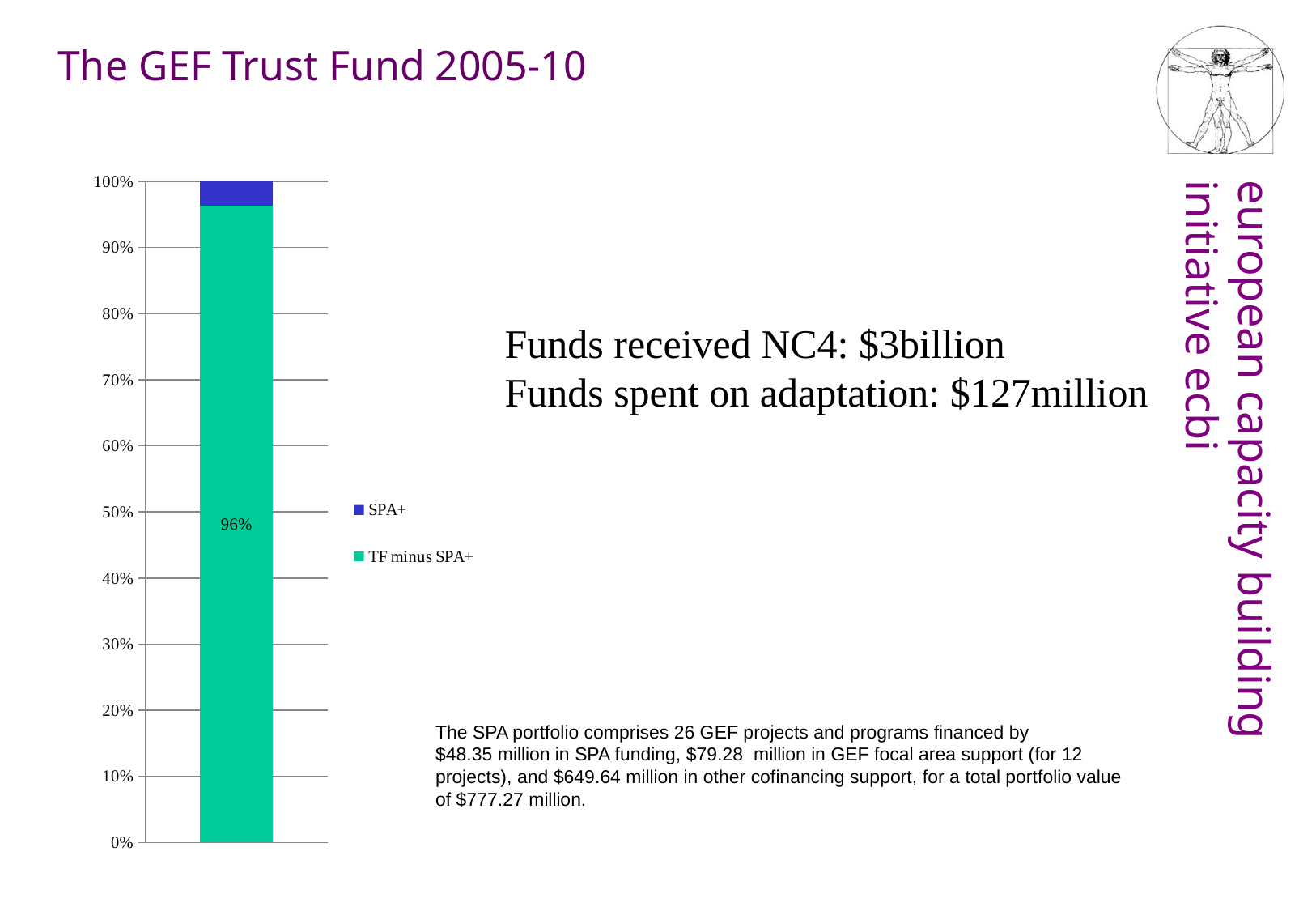
What are the two entries listed in the chart legend? SPA+ and TF minus SPA+ Which series takes up the larger share of the bar, SPA+ or TF minus SPA+? TF minus SPA+ What kind of chart is shown on the slide? Stacked bar chart How many series does the legend list? 2 Which series has the largest share of the stacked bar? TF minus SPA+ What percentage is shown for the TF minus SPA+ segment of the bar? 96% Is the value for TF minus SPA+ greater or less than 90%? greater Which series has the smallest share of the stacked bar? SPA+ How many bars are plotted in the chart? 1 What colour represents the SPA+ series in the chart? Blue Is the value for SPA+ greater or less than 10%? less What is the total height of the stacked bar on the percentage axis? 100%